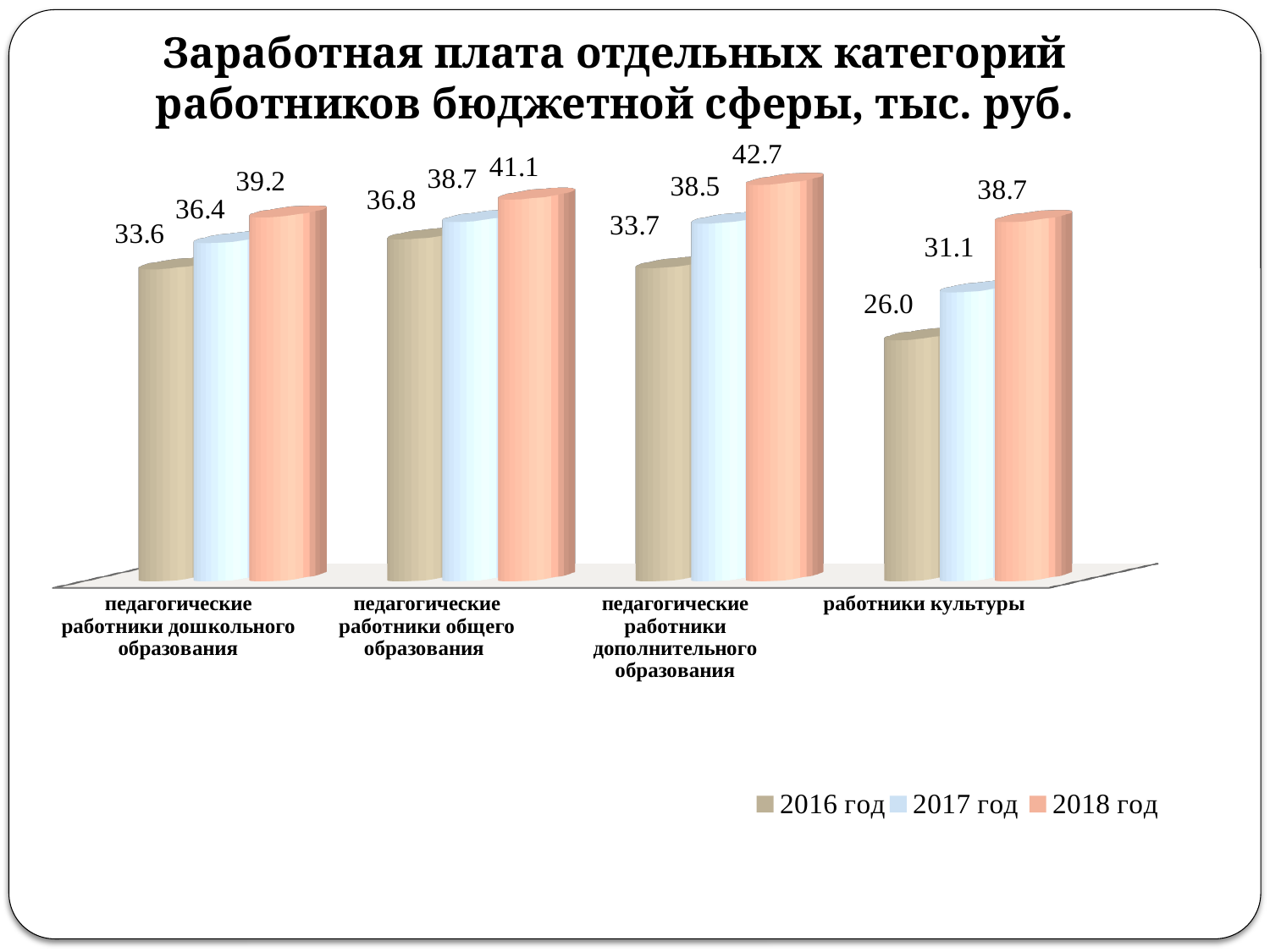
What is the difference between the 2018 год and 2016 год values for работники культуры? 12.7 Which is larger: the 2017 год value for педагогические работники общего образования or the 2017 год value for педагогические работники дошкольного образования? педагогические работники общего образования For работники культуры, do the values rise or fall from 2016 год to 2018 год? rise How many series does the legend list? 3 Which category has the lowest 2016 год value? работники культуры What is the 2017 год value for педагогические работники дополнительного образования? 38.5 What kind of chart is shown on the slide? bar chart What is the 2018 год value for работники культуры? 38.7 How many categories are shown on the x axis? 4 What is the 2016 год value for педагогические работники дошкольного образования? 33.6 What is the difference between the 2018 год values for педагогические работники общего образования and педагогические работники дошкольного образования? 1.9 Which category has the highest 2018 год value? педагогические работники дополнительного образования